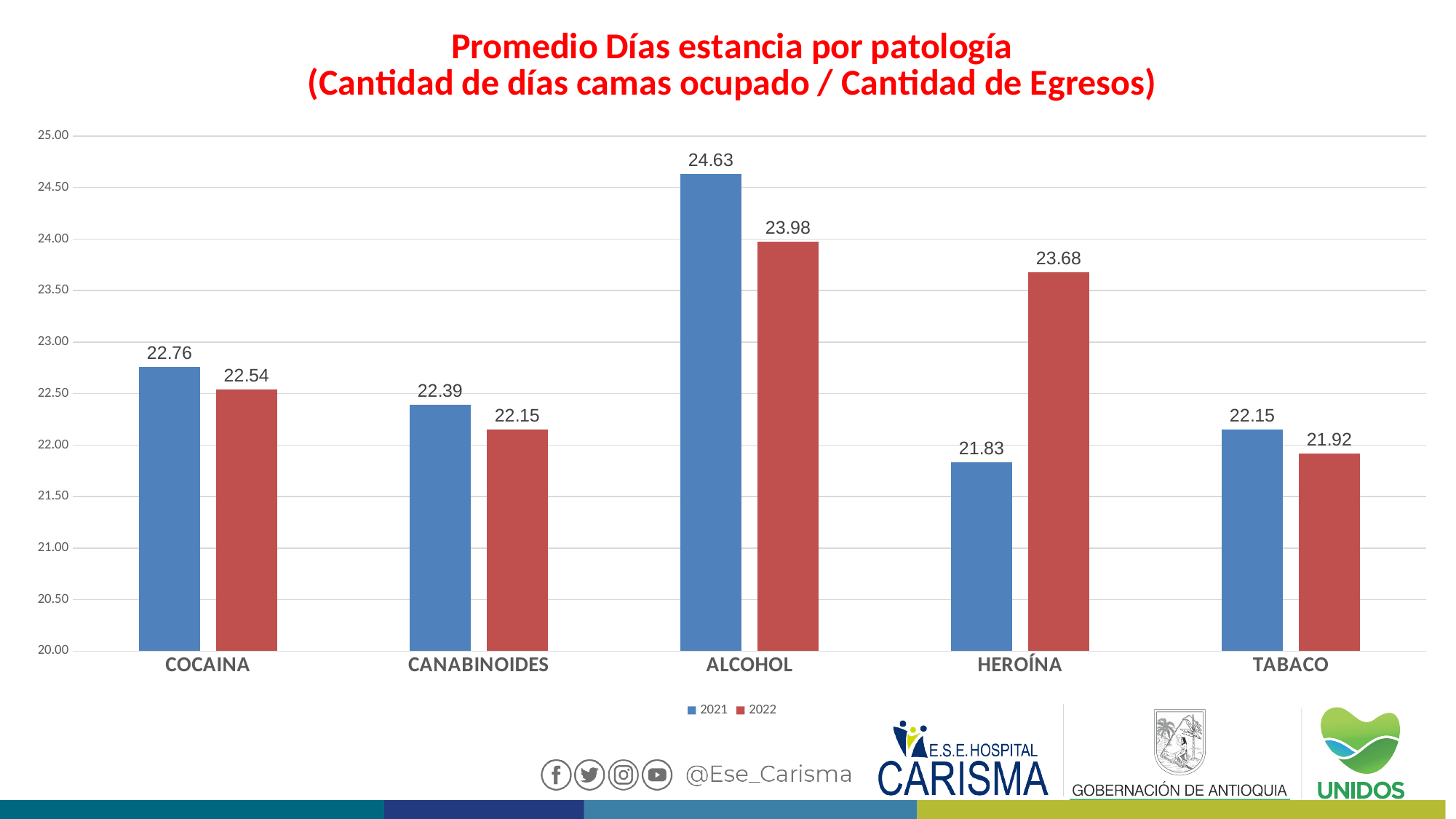
How many categories are shown on the x axis? 5 Which category has the highest 2021 value? ALCOHOL Which category has the lowest 2021 value? HEROÍNA What is the 2021 value for ALCOHOL? 24.63 Which is larger for COCAINA, the 2021 value or the 2022 value? 2021 What is the difference between the 2021 and 2022 values for ALCOHOL? 0.65 What is the difference between the 2022 and 2021 values for HEROÍNA? 1.85 What kind of chart is shown on the slide? Bar chart What is the 2022 value for HEROÍNA? 23.68 What is the 2022 value for CANABINOIDES? 22.15 How many series does the legend list? 2 Which category has the lowest 2022 value? TABACO